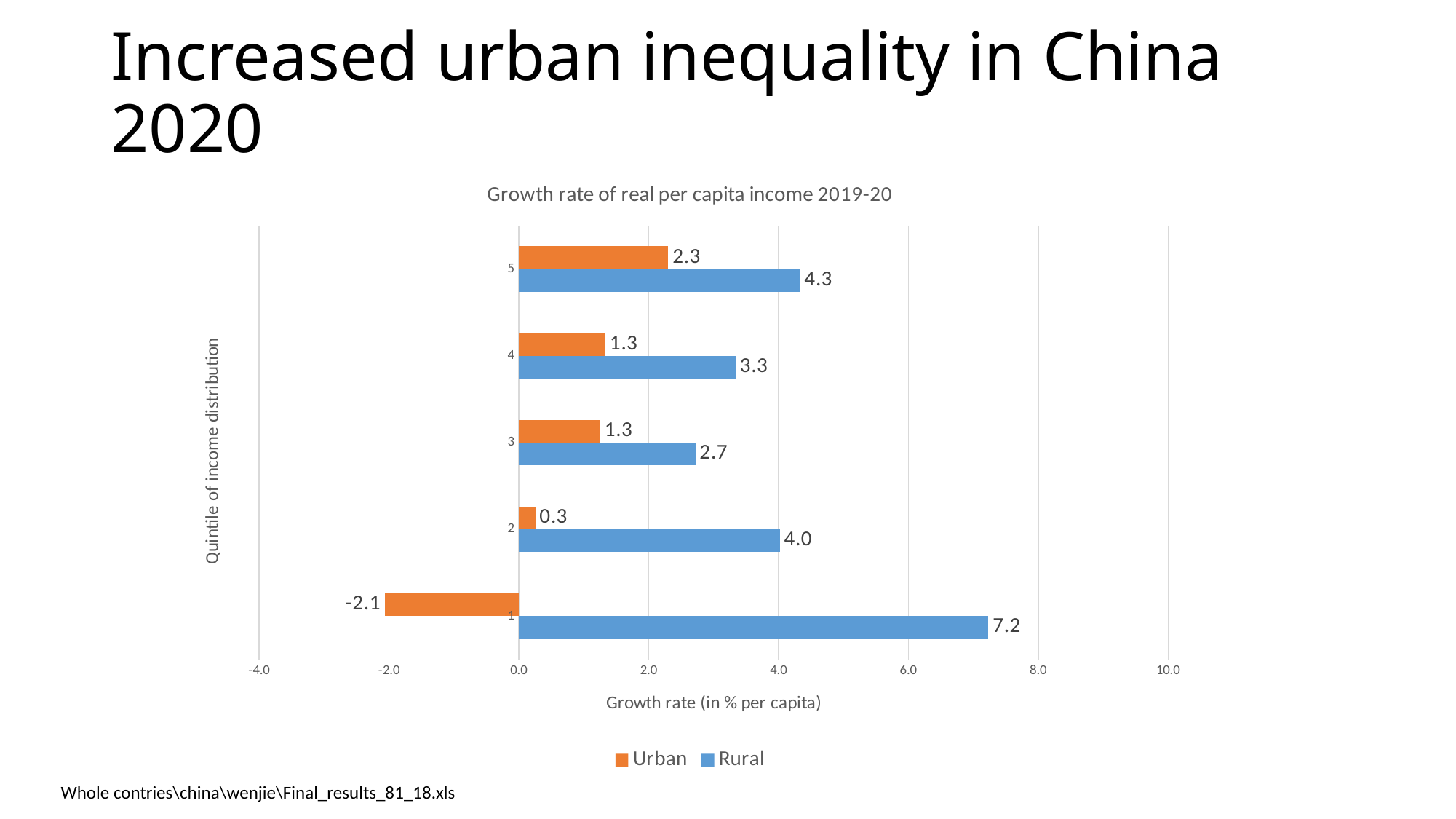
What is the Urban growth rate for quintile 1? -2.1 What is the Rural growth rate for quintile 2? 4.0 What is the Urban growth rate for quintile 5? 2.3 Which quintile has the highest Rural growth rate? 1 What is the difference between the Rural and Urban growth rates for quintile 5? 2.0 Which quintile has the lowest Urban growth rate? 1 What kind of chart is shown on the slide? Bar chart Which is larger for quintile 3, the Urban or the Rural growth rate? Rural How many quintiles are shown on the chart? 5 What is the title of the chart? Growth rate of real per capita income 2019-20 How many series does the legend list? 2 What is the Rural growth rate for quintile 1? 7.2